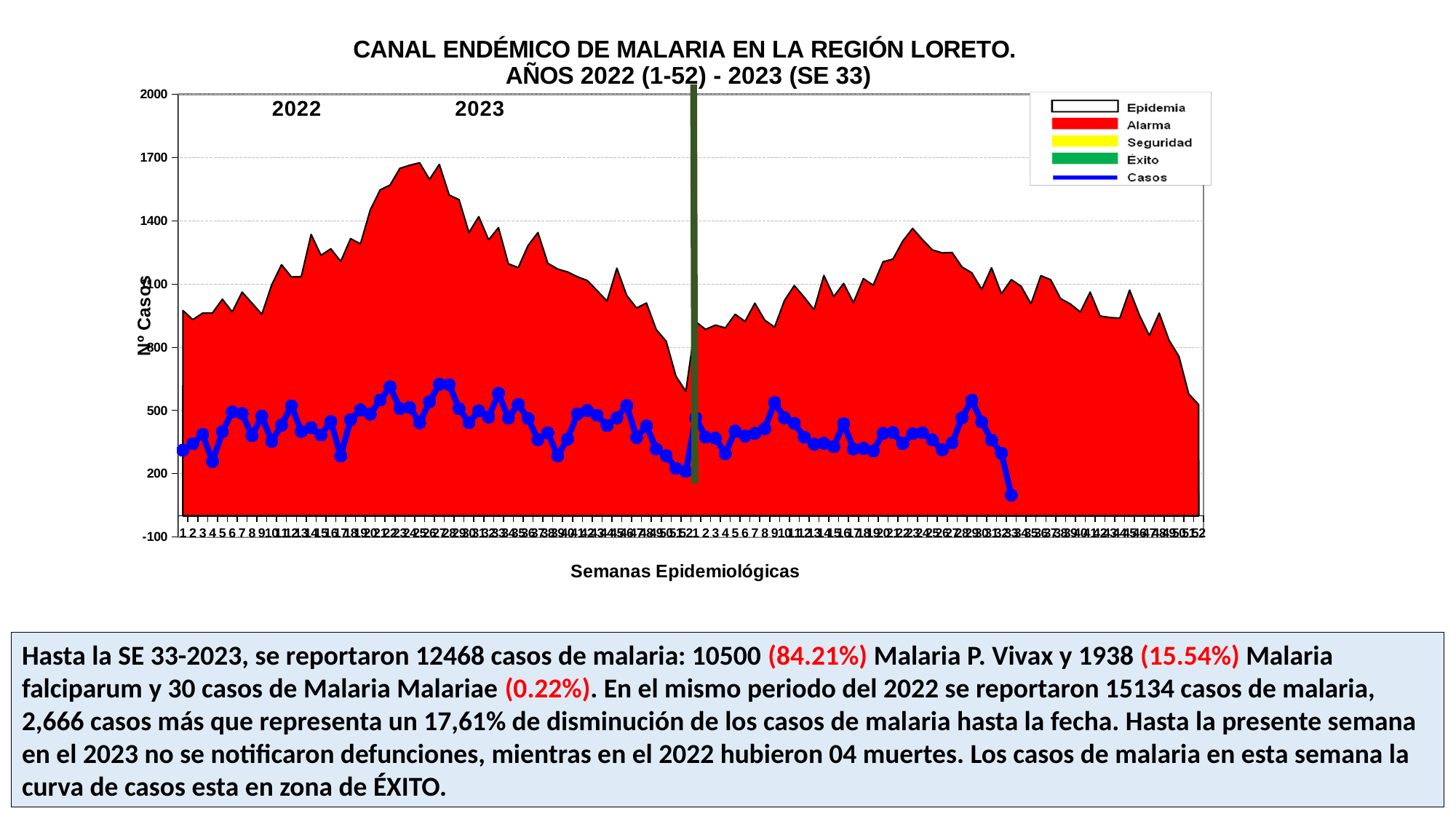
Is the highest point of the Casos line greater or less than 500? greater Is the top of the red Alarma area around week 25 of 2022 greater or less than 1400? greater What is the title of the chart? CANAL ENDÉMICO DE MALARIA EN LA REGIÓN LORETO. AÑOS 2022 (1-52) - 2023 (SE 33) What is the highest value shown on the y axis of the chart? 2000 Is the value of the Casos line at week 1 of 2022 greater or less than 200? greater Which is higher: the peak of the red Alarma area in 2022 or the peak of the red Alarma area in 2023? 2022 What kind of chart is shown on the slide? Area chart with a line Does the Casos line rise or fall over the last few plotted weeks of 2023 (weeks 29 to 33)? fall What is the label of the x axis of the chart? Semanas Epidemiológicas How many entries does the chart legend list? 5